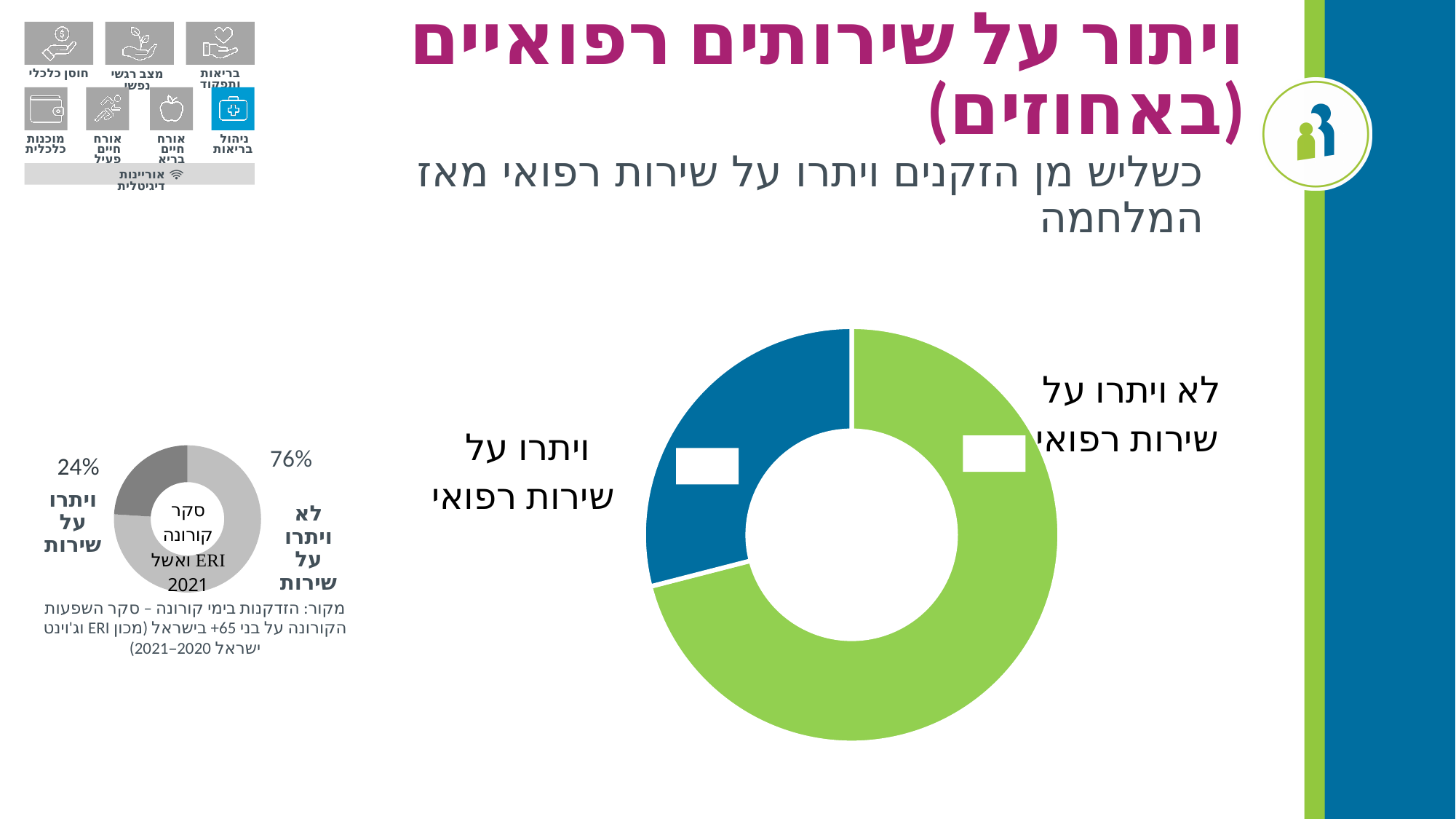
In the small grey donut chart on the left, what is the value for 'לא ויתרו על שירות'? 76% In the small grey donut chart on the left, which category has the largest share? לא ויתרו על שירות In the large donut chart in the centre, which category has the smallest slice? ויתרו על שירות רפואי What kind of chart is the large chart in the centre of the slide? Donut (pie) chart In the large donut chart in the centre, which category has the largest slice? לא ויתרו על שירות רפואי How many slices does the large donut chart in the centre have? 2 What text appears in the centre of the small grey donut chart on the left? סקר קורונה ואשל ERI 2021 In the large donut chart in the centre, which slice is larger: 'ויתרו על שירות רפואי' or 'לא ויתרו על שירות רפואי'? לא ויתרו על שירות רפואי In the small grey donut chart on the left, what is the value for 'ויתרו על שירות'? 24% In the small grey donut chart on the left, is the value for 'ויתרו על שירות' greater or less than 50%? less In the large donut chart in the centre, what colour is the slice for 'ויתרו על שירות רפואי'? Blue In the small grey donut chart on the left, what is the difference between 'לא ויתרו על שירות' and 'ויתרו על שירות'? 52 percentage points